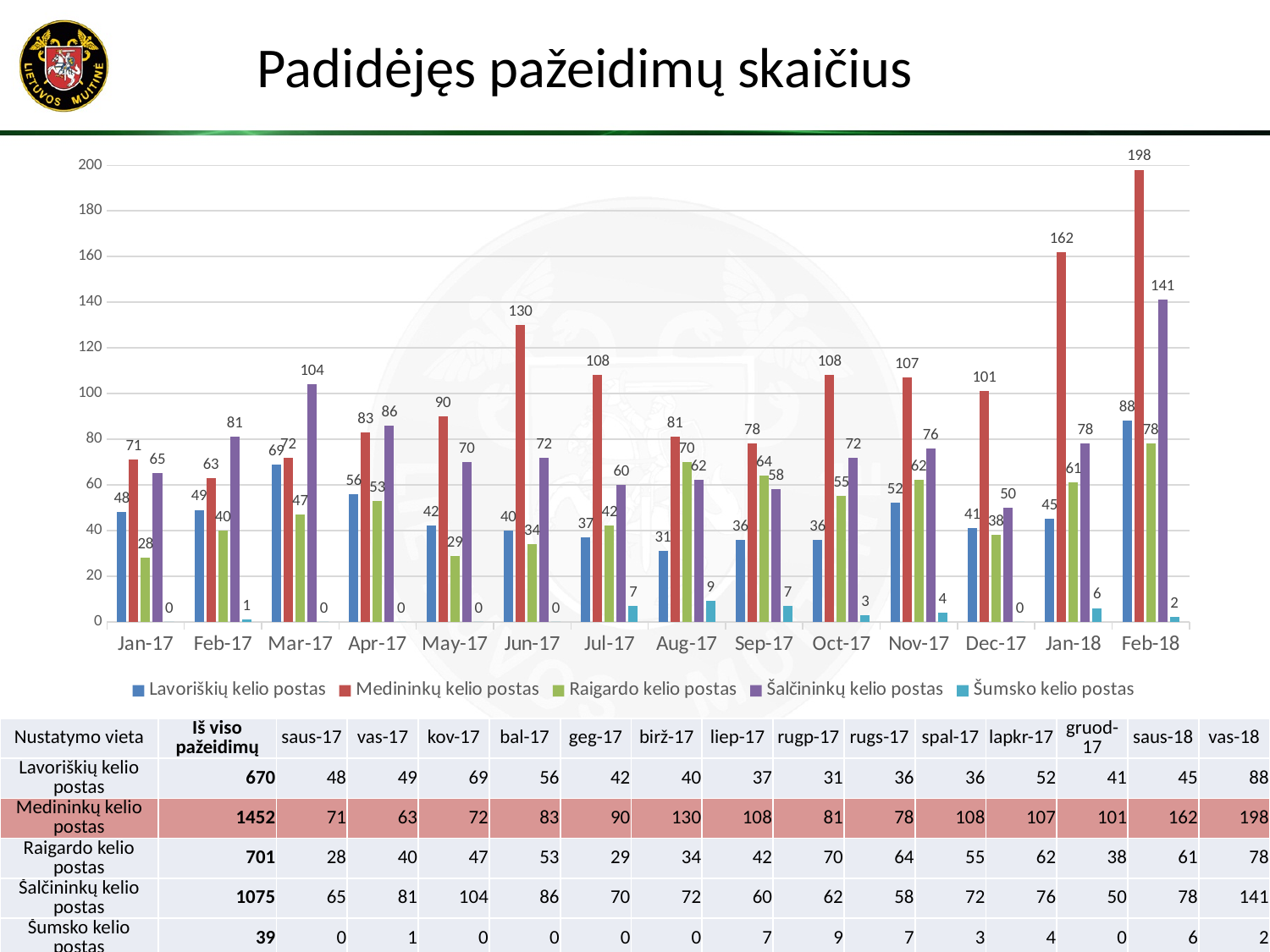
What is the difference between Medininkų kelio postas and Lavoriškių kelio postas in Jan-18? 117 What is the value for Medininkų kelio postas in Feb-18? 198 What is the title of the slide? Padidėjęs pažeidimų skaičius What is the value for Šalčininkų kelio postas in Mar-17? 104 What is the value for Raigardo kelio postas in Aug-17? 70 In which month does Medininkų kelio postas reach its highest value? Feb-18 What kind of chart is shown on the slide? bar chart How many months are shown on the x axis? 14 In which month does Lavoriškių kelio postas have its lowest value? Aug-17 Which is larger in Apr-17: Šalčininkų kelio postas or Medininkų kelio postas? Šalčininkų kelio postas How many series does the legend list? 5 Does the value for Medininkų kelio postas rise or fall from Dec-17 to Feb-18? rise